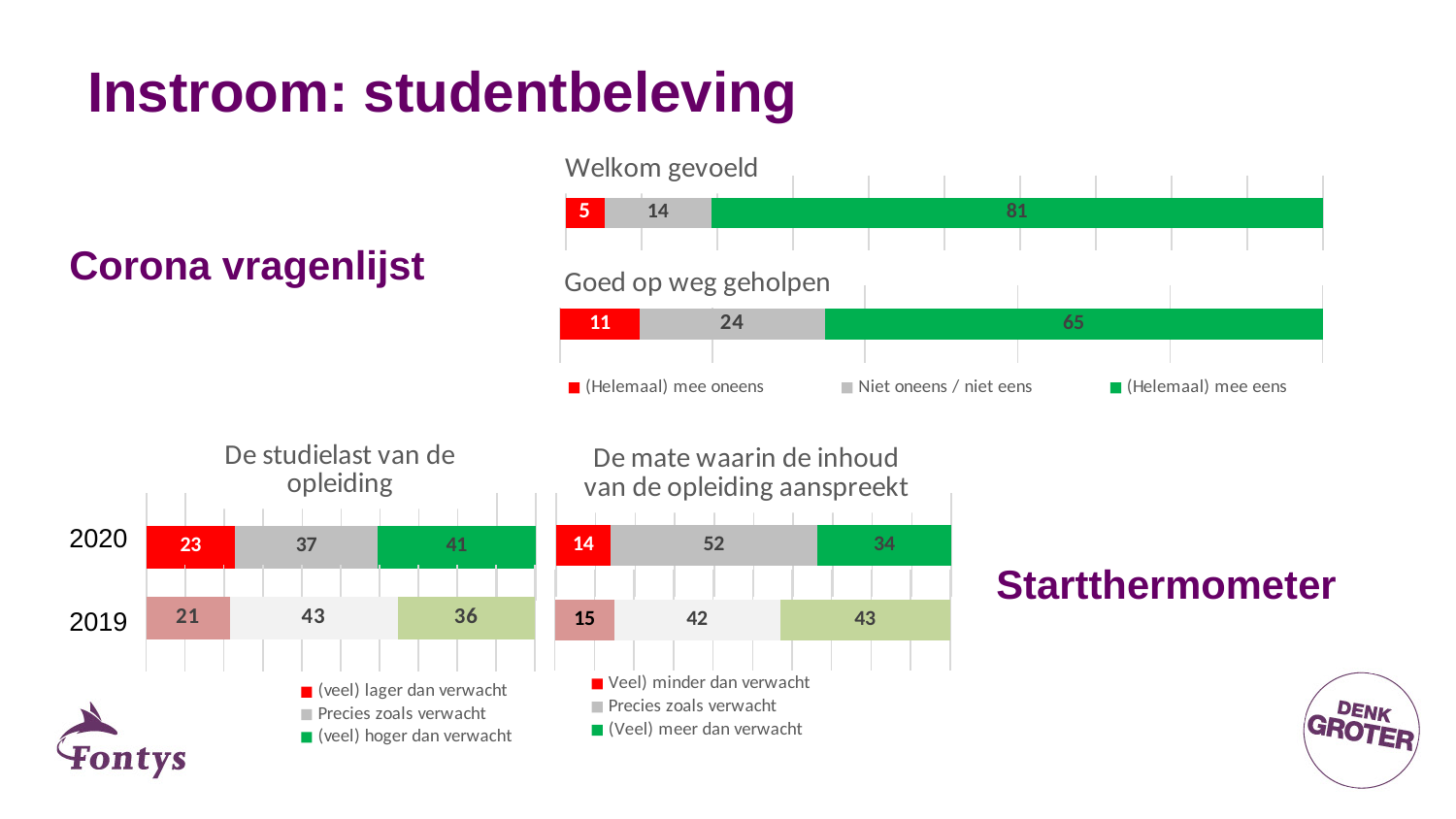
In the 'De mate waarin de inhoud van de opleiding aanspreekt' chart, which segment is the largest in 2020? Precies zoals verwacht In the 'De studielast van de opleiding' chart, what is the value for 'Precies zoals verwacht' in 2019? 43 In the 'Welkom gevoeld' chart, what is the total of the stacked bar? 100 In the 'Goed op weg geholpen' chart, what is the value for '(Helemaal) mee oneens'? 11 What kind of chart is 'De studielast van de opleiding'? Stacked bar chart How many series does the legend of the 'Welkom gevoeld' and 'Goed op weg geholpen' charts list? 3 In the 'De mate waarin de inhoud van de opleiding aanspreekt' chart, what is the difference between '(Veel) meer dan verwacht' in 2019 and in 2020? 9 In the 'De studielast van de opleiding' chart, what is the value for '(veel) hoger dan verwacht' in 2020? 41 In the 'Goed op weg geholpen' chart, what is the value for 'Niet oneens / niet eens'? 24 In the 'Welkom gevoeld' chart, what is the value for '(Helemaal) mee eens'? 81 In the 'De mate waarin de inhoud van de opleiding aanspreekt' chart, what is the value for 'Precies zoals verwacht' in 2020? 52 In the 'De studielast van de opleiding' chart, which year has the larger value for '(veel) lager dan verwacht', 2020 or 2019? 2020